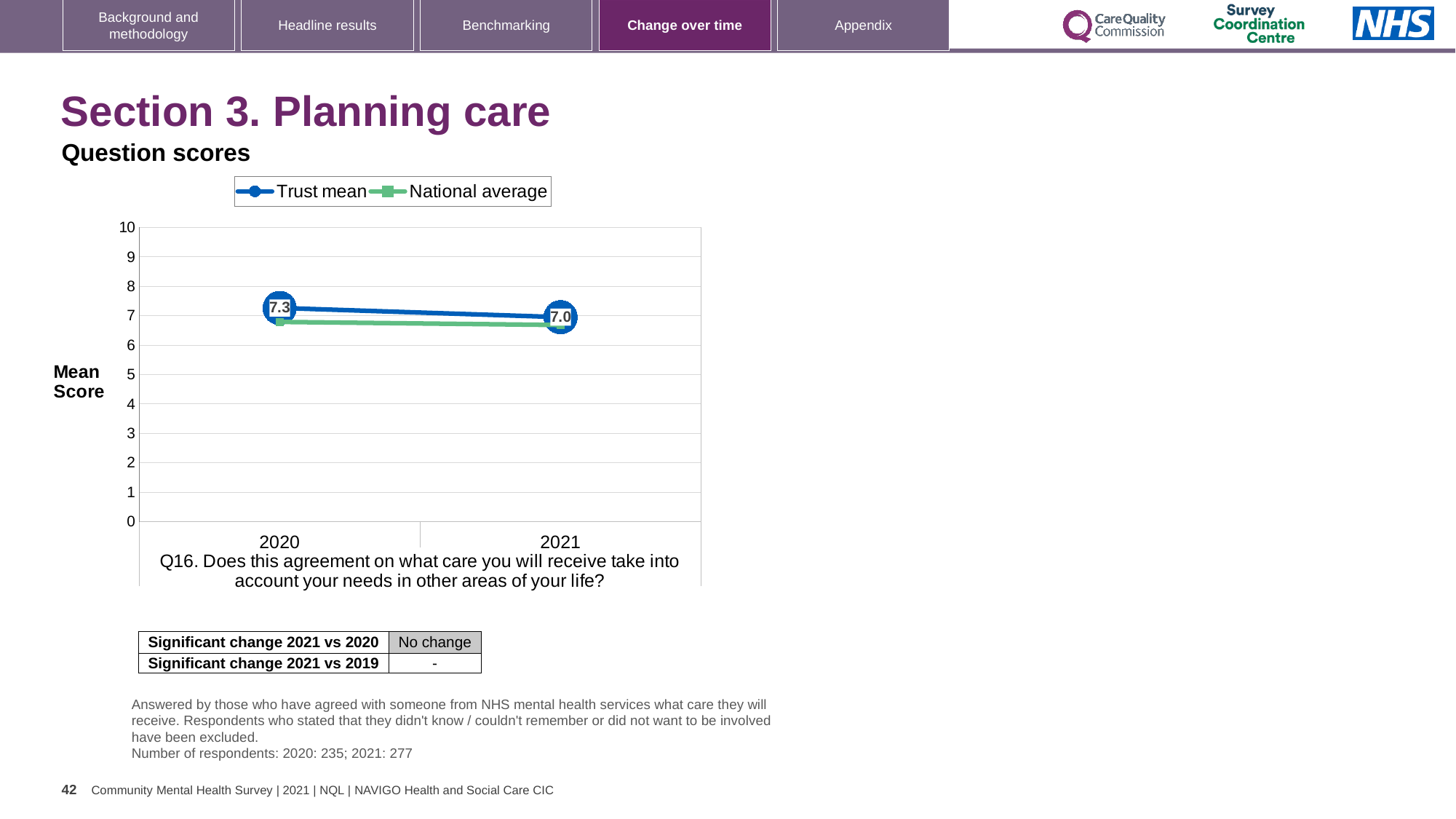
In 2020, which is larger: the Trust mean or the National average? Trust mean Does the Trust mean rise or fall from 2020 to 2021? fall What is the Trust mean score for 2020? 7.3 How many series does the legend list? 2 Is the National average value for 2020 greater or less than 5? greater In which year is the Trust mean score higher? 2020 How many years are plotted on the x axis? 2 By how much did the Trust mean score change from 2020 to 2021? 0.3 What is the label on the y axis of the chart? Mean Score Is the National average value for 2021 greater or less than 8? less What kind of chart is shown on the slide? line chart What is the Trust mean score for 2021? 7.0